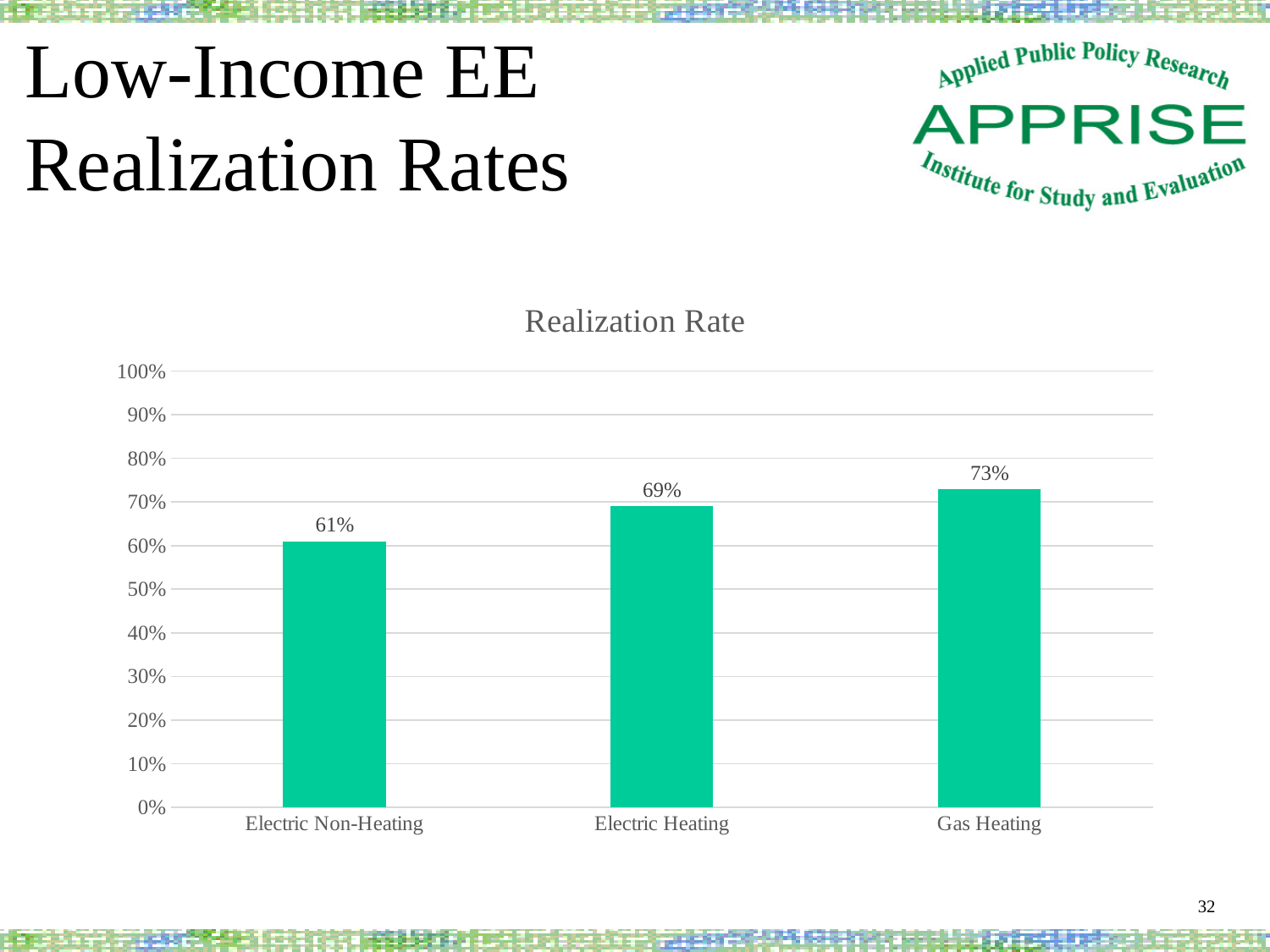
What is the realization rate for Gas Heating? 73% How many categories are shown in the chart? 3 What is the difference between the realization rates for Gas Heating and Electric Non-Heating? 12% What is the realization rate for Electric Non-Heating? 61% Which category has the highest realization rate? Gas Heating What is the realization rate for Electric Heating? 69% Which category has the lowest realization rate? Electric Non-Heating Which has a higher realization rate, Electric Heating or Gas Heating? Gas Heating What is the title of the chart? Realization Rate What is the difference between the realization rates for Electric Heating and Electric Non-Heating? 8% Is the realization rate for Electric Non-Heating greater or less than 70%? less What kind of chart is shown on the slide? bar chart